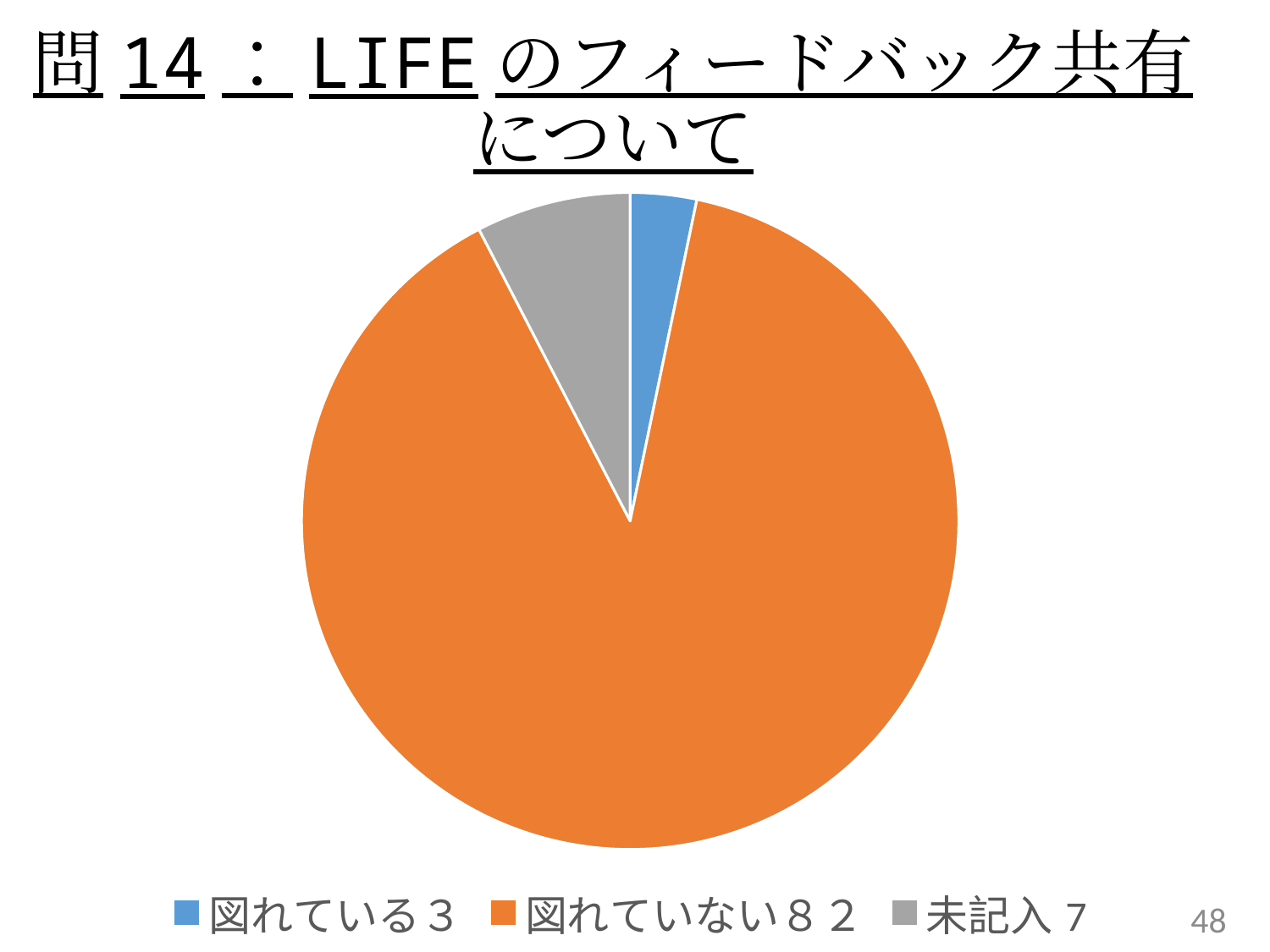
What is the total of all three categories in the pie chart? 92 Which is larger, the value for 未記入 or the value for 図れている? 未記入 Which category has the smallest slice of the pie? 図れている What is the value for 図れている? ３ How many categories does the pie chart have? 3 What is the value for 図れていない? ８２ What is the difference between the values for 未記入 and 図れている? 4 What colour is the slice for 図れていない? orange What is the value for 未記入? ７ Which category has the largest slice of the pie? 図れていない What is the difference between the values for 図れていない and 未記入? 75 What kind of chart is shown on the slide? pie chart